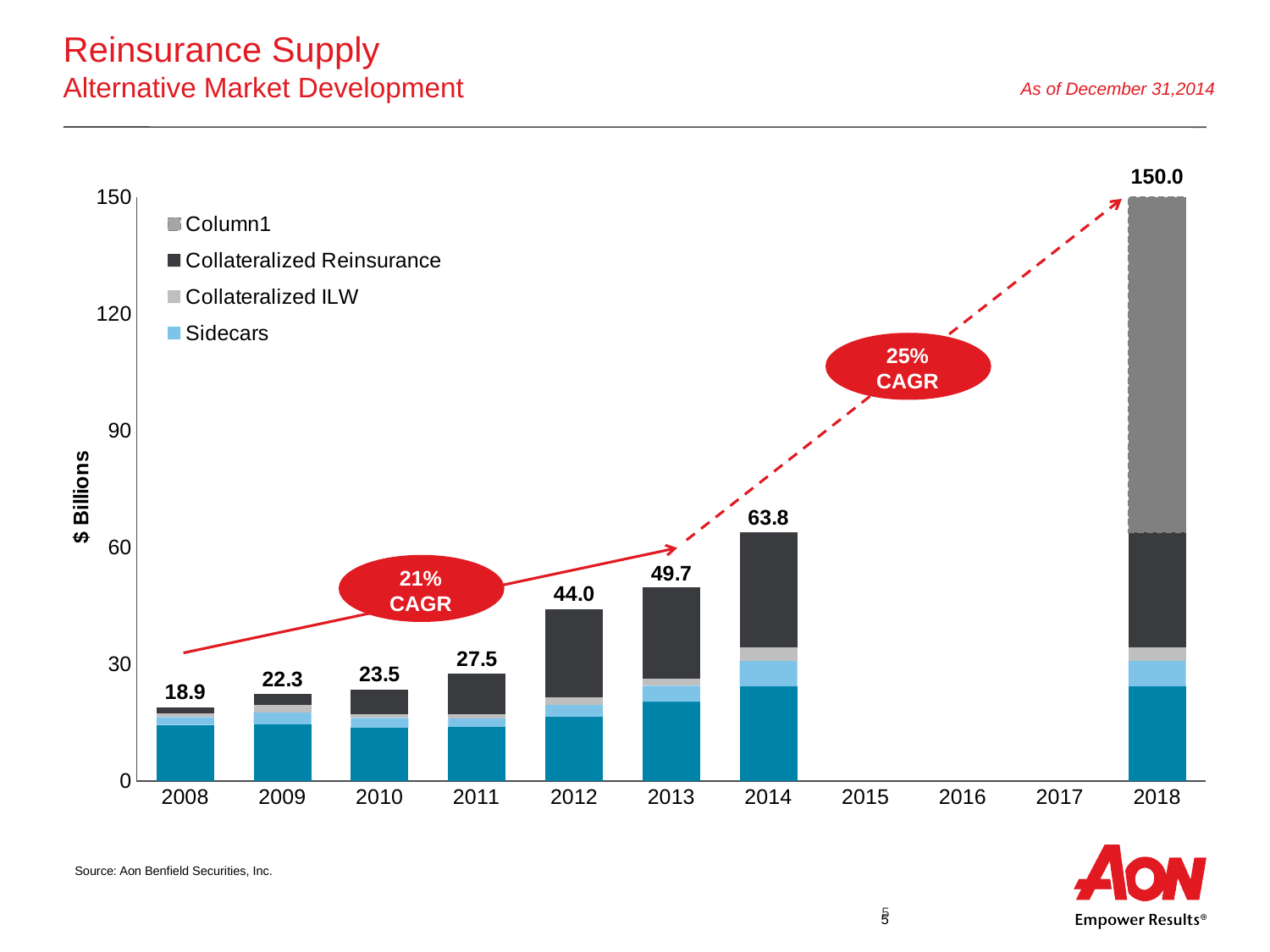
How many series does the legend list? 4 How many years have a bar plotted on the chart? 8 What is the total value labeled for 2008? 18.9 What is the label on the vertical axis? $ Billions What kind of chart is shown on the slide? Stacked bar chart What is the total value labeled for 2018? 150.0 Which year has the lowest labeled total? 2008 Is the total for 2013 greater or less than 60? less Which is larger, the labeled total for 2012 or for 2011? 2012 What is the total value labeled for 2014? 63.8 Which year has the highest labeled total? 2018 What is the difference between the labeled totals for 2014 and 2013? 14.1